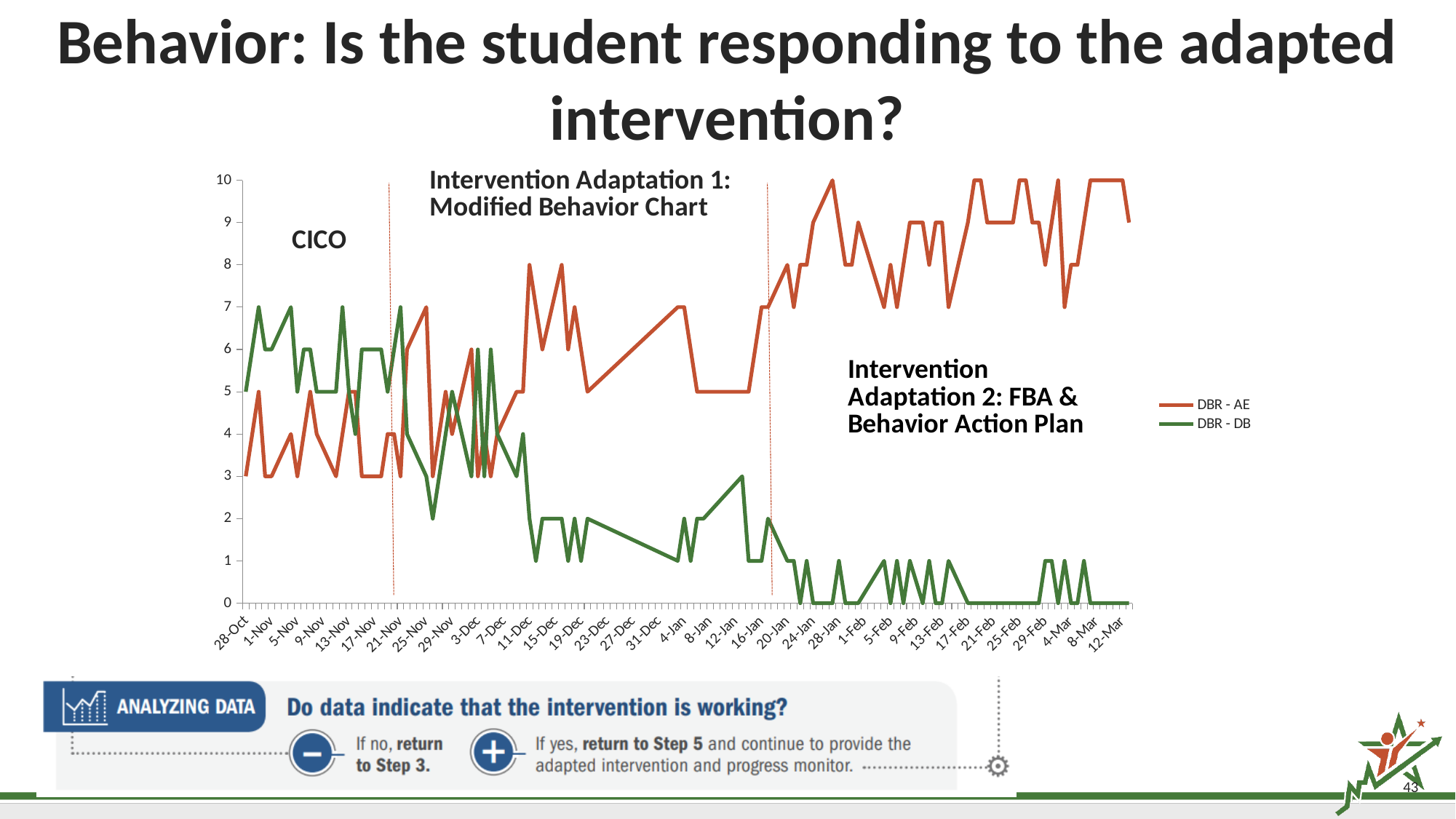
What are the two series named in the legend? DBR - AE and DBR - DB Does the DBR - AE series generally rise or fall from 28-Oct to 12-Mar? Rise What is the highest value reached by the DBR - AE series? 10 Which series is drawn in green? DBR - DB How many series does the legend list? 2 Is the value for DBR - AE at 12-Mar greater or less than 5? greater What is the lowest value reached by the DBR - DB series? 0 At 12-Mar, which series has the higher value, DBR - AE or DBR - DB? DBR - AE At 28-Oct, which series has the higher value, DBR - AE or DBR - DB? DBR - DB Does the DBR - DB series generally rise or fall from 28-Oct to 12-Mar? Fall What kind of chart is shown on the slide? Line chart Is the value for DBR - DB at 12-Mar greater or less than 5? less